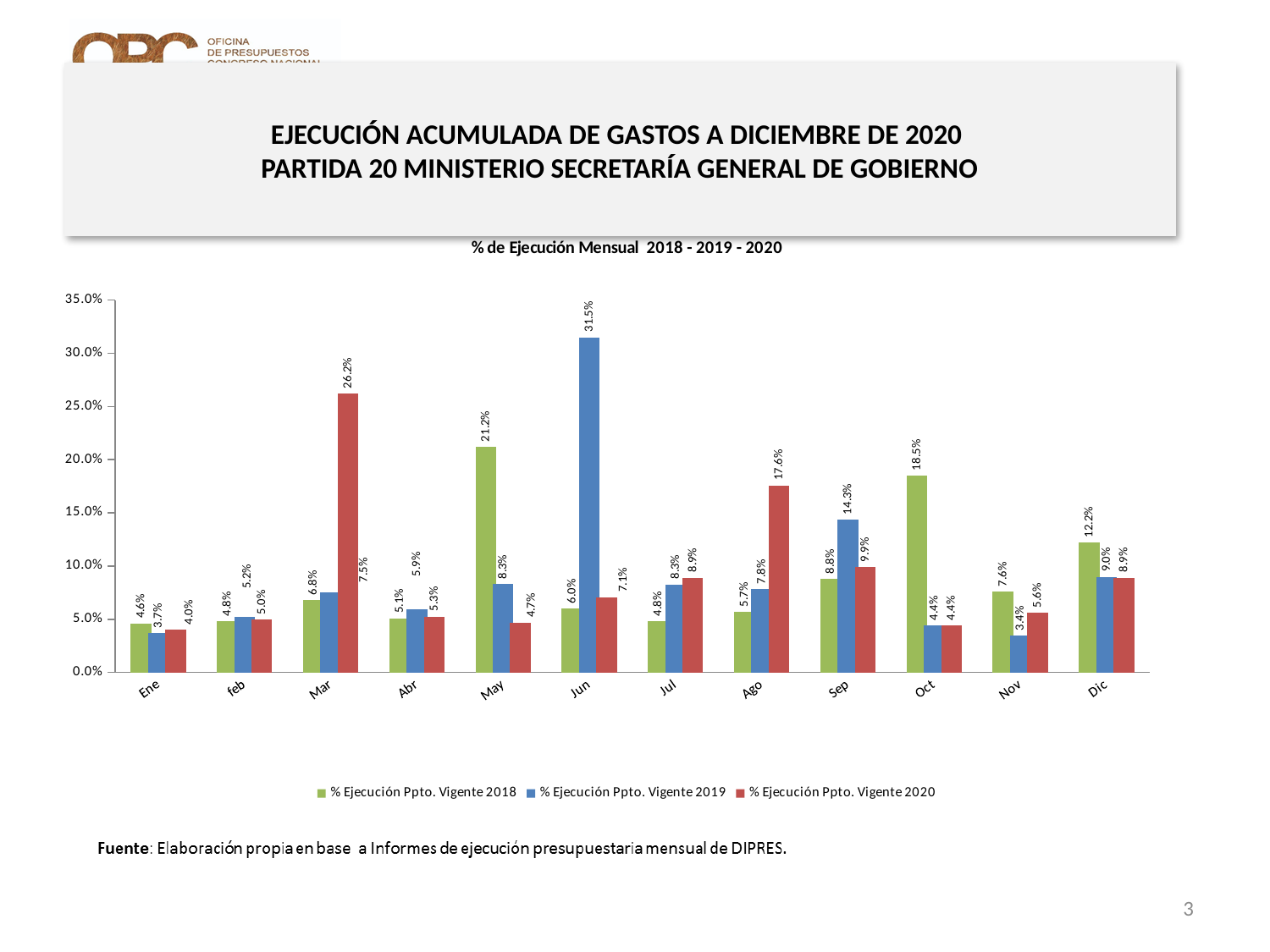
In which month is the % Ejecución Ppto. Vigente 2018 series highest? May In which month is the % Ejecución Ppto. Vigente 2019 series lowest? Nov How many months are shown on the x axis? 12 What is the title of the chart? % de Ejecución Mensual 2018 - 2019 - 2020 Is the value for % Ejecución Ppto. Vigente 2019 in Jun greater or less than 30.0%? greater What is the value for % Ejecución Ppto. Vigente 2020 in Mar? 26.2% What is the difference between the 2020 and 2018 values in Ago? 11.9% How many series does the legend list? 3 Which is larger in Sep: the 2019 value or the 2020 value? 2019 value (14.3%) What is the value for % Ejecución Ppto. Vigente 2018 in Oct? 18.5% What kind of chart is shown on the slide? Bar chart What is the value for % Ejecución Ppto. Vigente 2019 in Jun? 31.5%